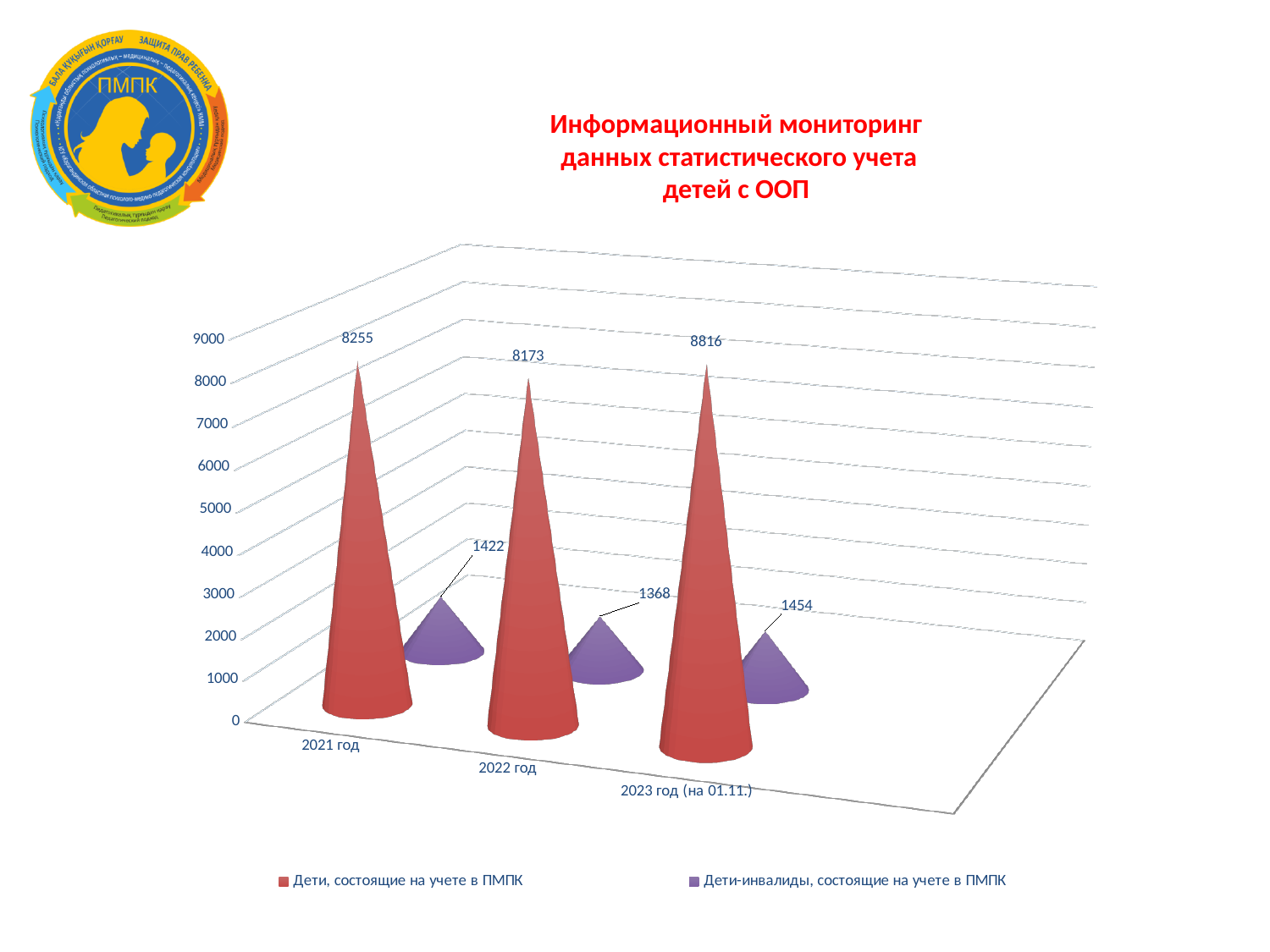
Which is larger: the value for "Дети-инвалиды, состоящие на учете в ПМПК" in 2021 год or in 2023 год (на 01.11.)? 2023 год (на 01.11.) What is the difference between the values for "Дети, состоящие на учете в ПМПК" in 2023 год (на 01.11.) and 2022 год? 643 In which year is the value for "Дети, состоящие на учете в ПМПК" highest? 2023 год (на 01.11.) What is the value for "Дети, состоящие на учете в ПМПК" in 2021 год? 8255 What kind of chart is shown on the slide? 3D bar chart (cone-shaped bars) What is the value for "Дети-инвалиды, состоящие на учете в ПМПК" in 2022 год? 1368 How many series does the legend list? 2 What is the value for "Дети, состоящие на учете в ПМПК" in 2023 год (на 01.11.)? 8816 How many year categories are shown on the x axis? 3 What is the difference between the values for "Дети-инвалиды, состоящие на учете в ПМПК" in 2023 год (на 01.11.) and 2021 год? 32 In which year is the value for "Дети-инвалиды, состоящие на учете в ПМПК" lowest? 2022 год What colour represents the series "Дети-инвалиды, состоящие на учете в ПМПК"? Purple